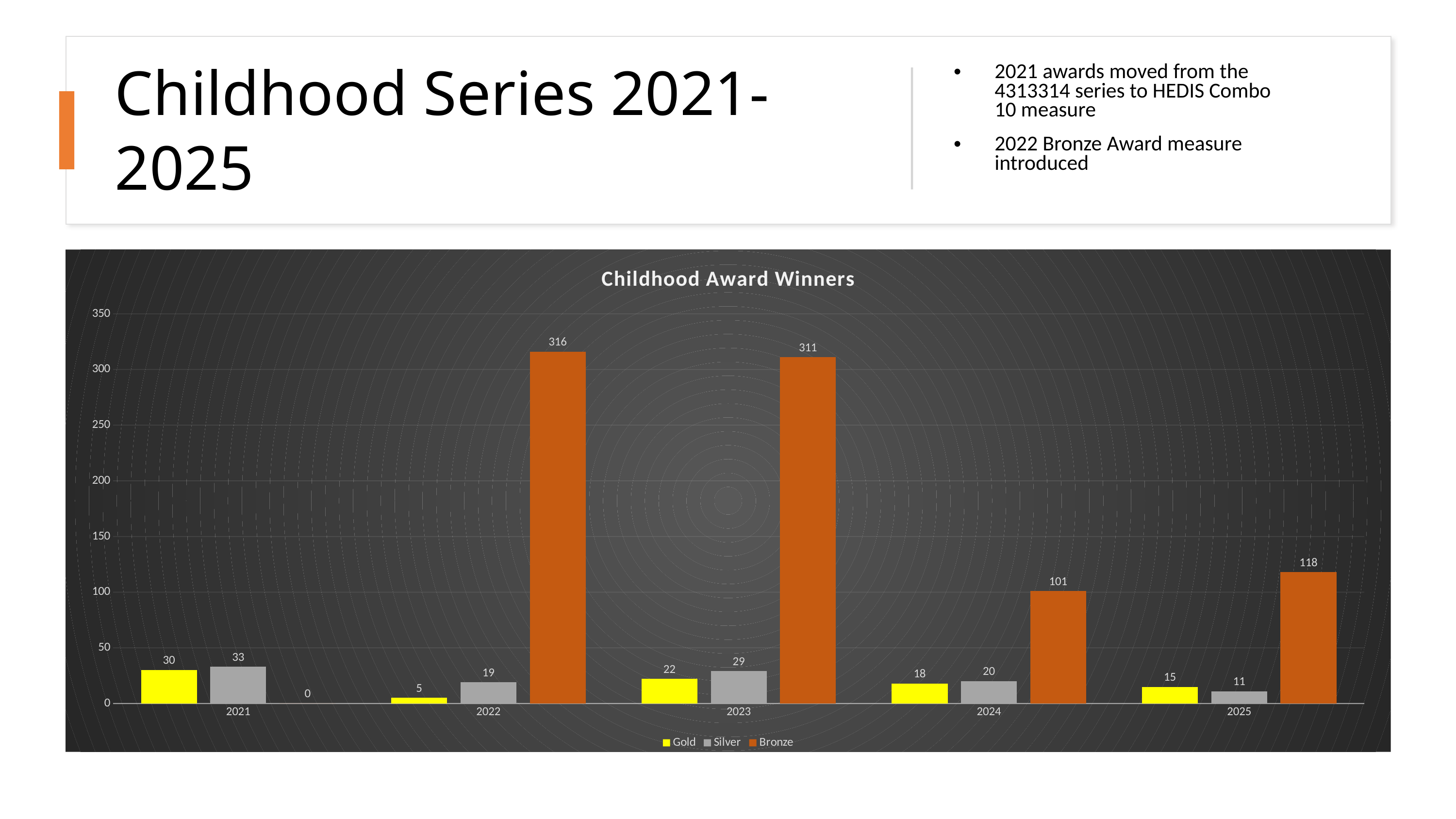
What is the Gold value for 2021? 30 How many years are shown on the x axis? 5 How many series does the legend list? 3 What is the Silver value for 2025? 11 Is the Bronze value for 2024 greater or less than 150? less What is the difference between the Bronze values for 2022 and 2023? 5 Which is larger, the Silver value for 2021 or the Silver value for 2023? Silver value for 2021 What is the Bronze value for 2022? 316 Which year has the lowest Gold value? 2022 What kind of chart is shown? bar chart Which year has the highest Bronze value? 2022 What is the title of the chart? Childhood Award Winners